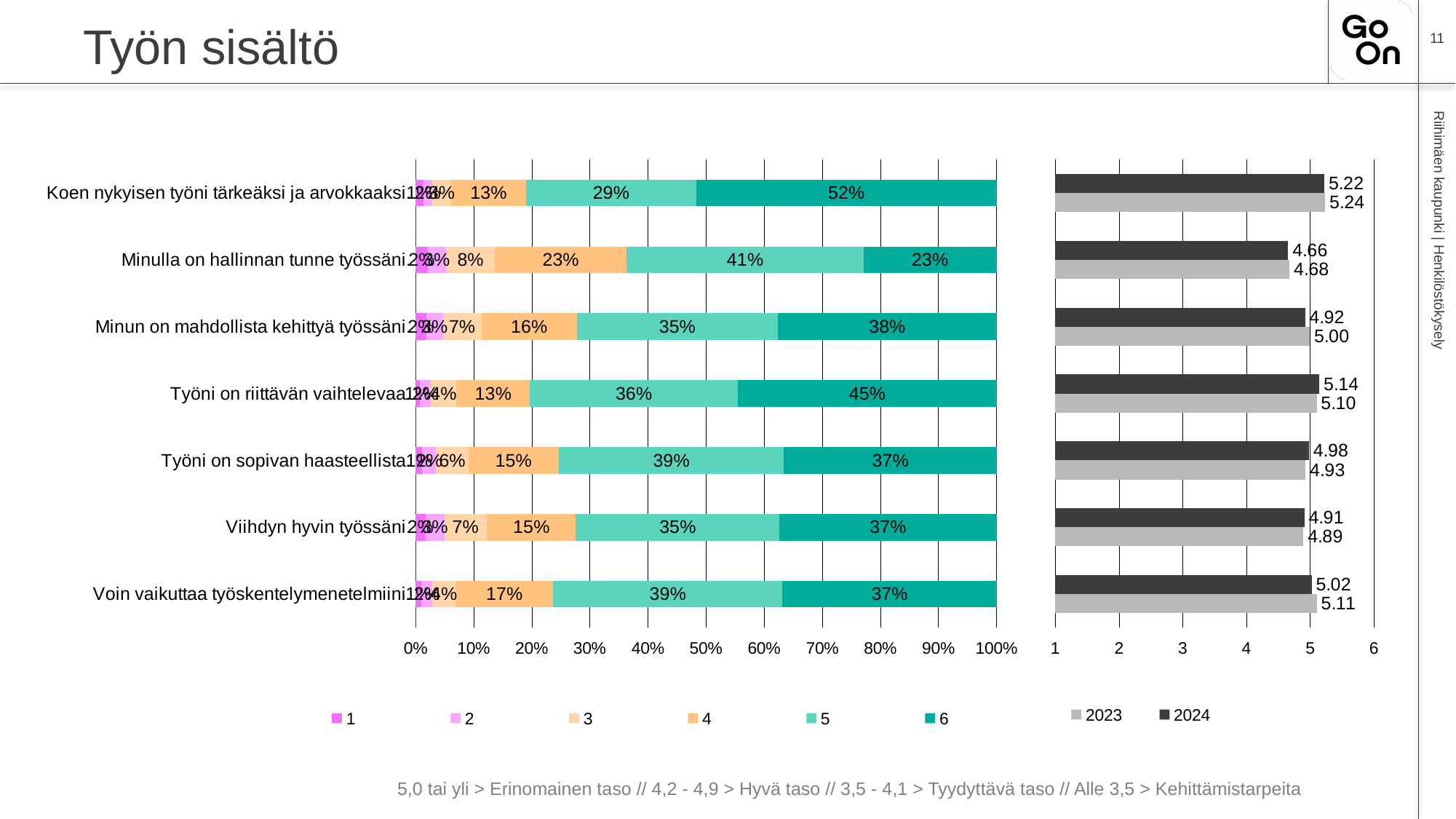
In the left stacked bar chart, what percentage of respondents gave a 6 for "Koen nykyisen työni tärkeäksi ja arvokkaaksi"? 52% In the left stacked bar chart, which statement has the lowest share of 6 responses? Minulla on hallinnan tunne työssäni How many series does the legend of the left stacked bar chart list? 6 In the right chart, what is the 2024 value for "Työni on riittävän vaihtelevaa"? 5.14 In the left stacked bar chart, which statement has the highest share of 6 responses? Koen nykyisen työni tärkeäksi ja arvokkaaksi In the right chart, what is the difference between the 2023 and 2024 values for "Minun on mahdollista kehittyä työssäni"? 0.08 In the right chart, which statement has the highest 2024 value? Koen nykyisen työni tärkeäksi ja arvokkaaksi In the left stacked bar chart, what percentage of respondents gave a 5 for "Minulla on hallinnan tunne työssäni"? 41% In the right chart, which year has the larger value for "Työni on sopivan haasteellista", 2023 or 2024? 2024 In the right chart, what is the 2023 value for "Voin vaikuttaa työskentelymenetelmiini"? 5.11 How many statements (categories) are shown in the left stacked bar chart? 7 In the right chart, which statement has the lowest 2023 value? Minulla on hallinnan tunne työssäni